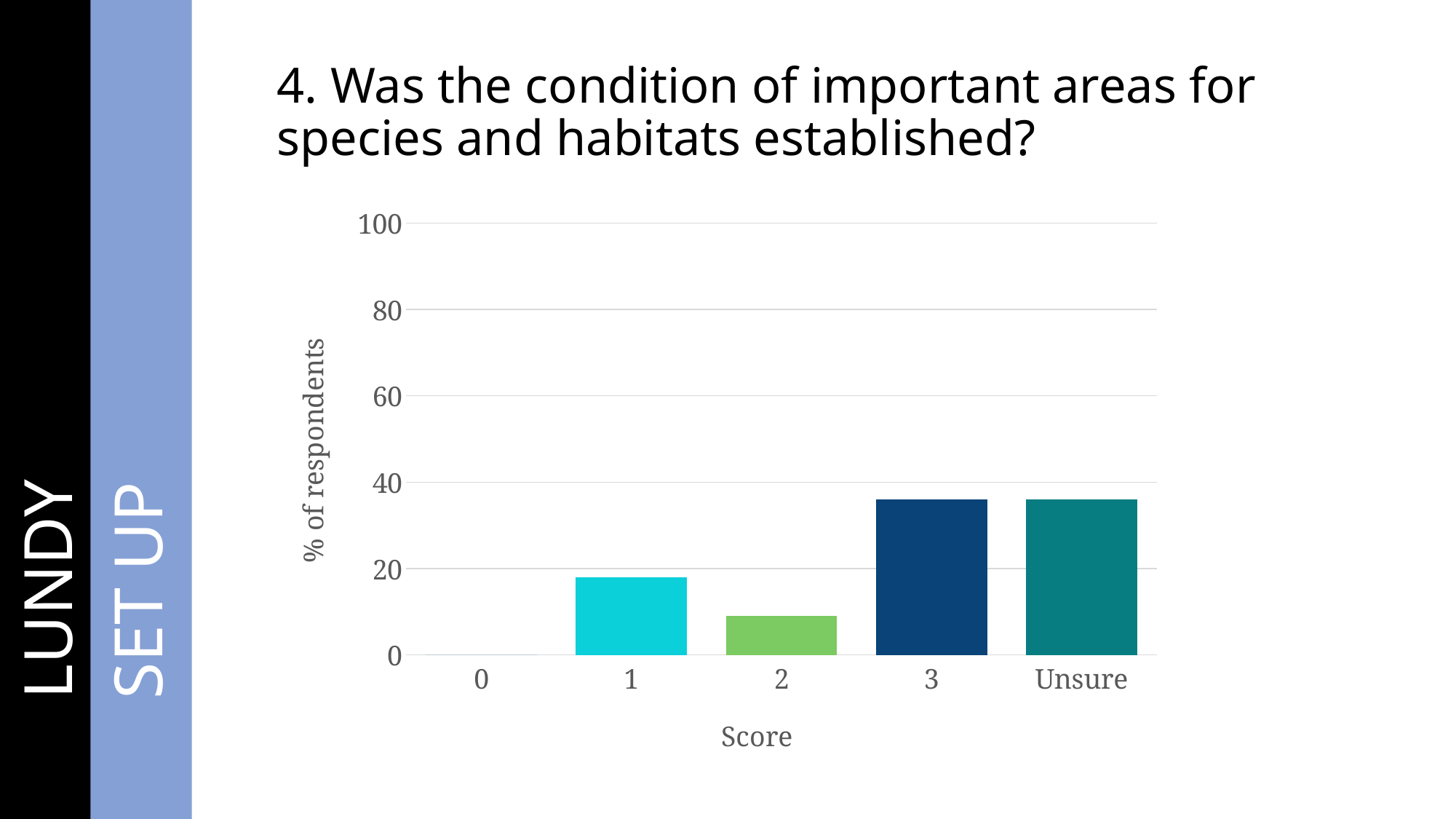
Is the value for Unsure greater or less than 40? less What is the label of the x axis? Score Is the value for score 2 greater or less than 20? less Which has a higher percentage of respondents, Unsure or score 1? Unsure Is the value for score 1 greater or less than 20? less Which has a higher percentage of respondents, score 3 or score 2? 3 Which has a higher percentage of respondents, score 1 or score 2? 1 Which score category has the lowest percentage of respondents? 0 What is the label of the y axis? % of respondents How many score categories are shown on the x axis? 5 What kind of chart is shown on the slide? bar chart